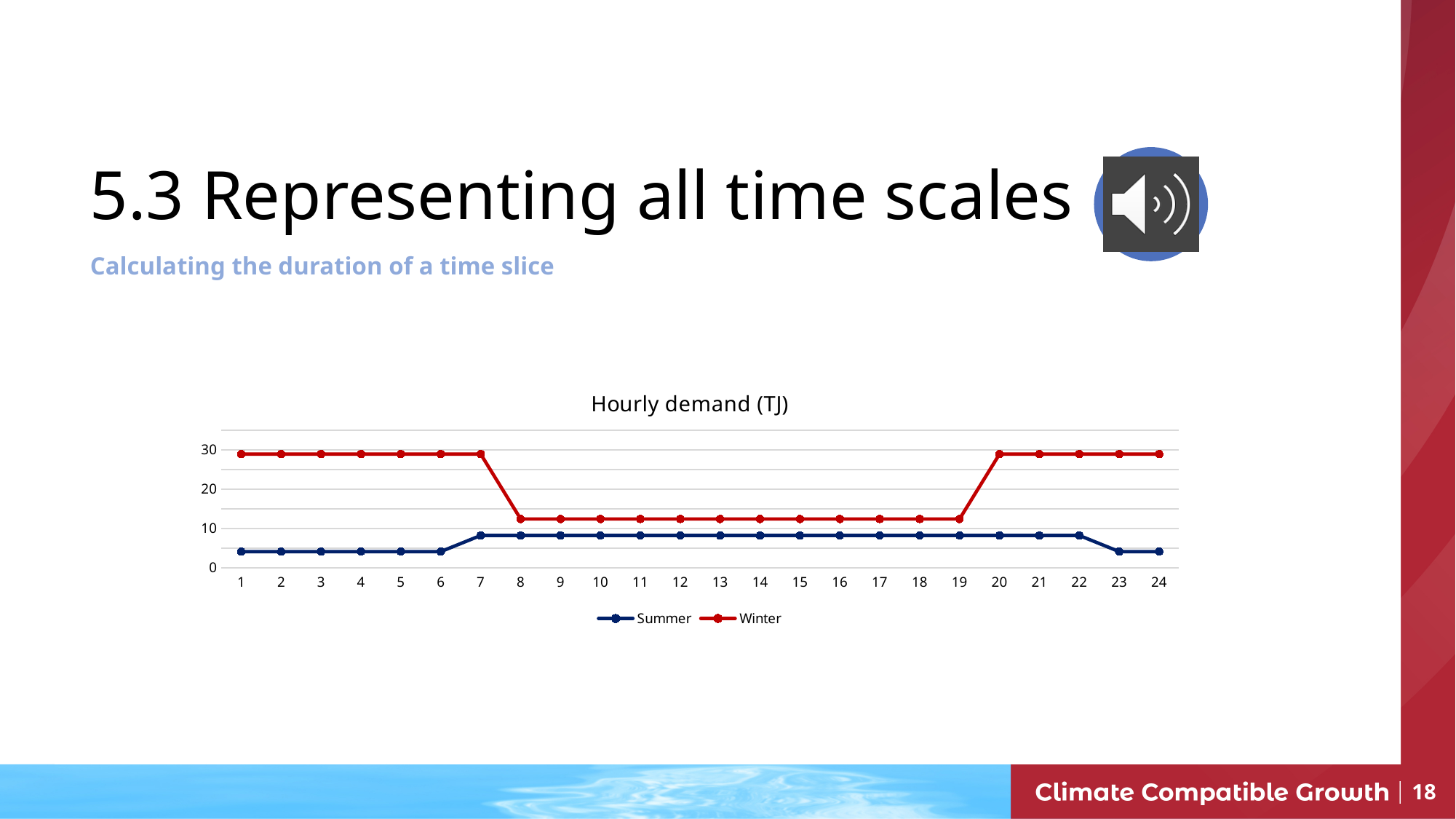
Is the Winter value at hour 12 greater or less than 20? less What kind of chart is shown on the slide? line chart Is the Summer value at hour 10 greater or less than 10? less How many hours are plotted along the x axis? 24 How many series does the legend list? 2 What is the title of the chart? Hourly demand (TJ) Does the Summer series rise or fall between hour 6 and hour 7? rise Does the Winter series rise or fall between hour 7 and hour 8? fall Is the Winter value at hour 3 greater or less than 20? greater At hour 15, which series has the larger value, Summer or Winter? Winter Which series is drawn in red? Winter